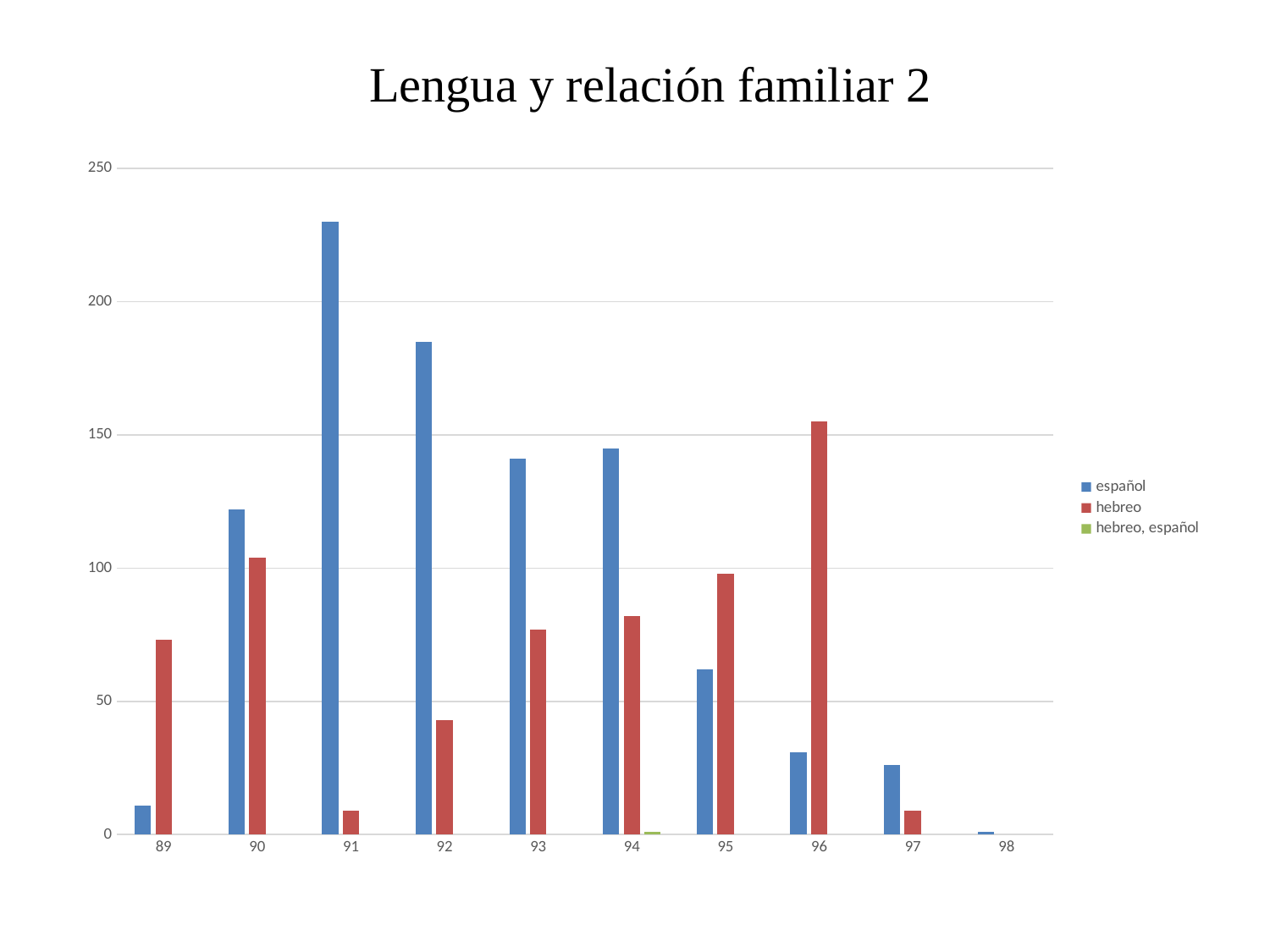
Is the español value for 91 greater or less than 200? greater For which category is the español bar the highest? 91 Is the hebreo value for 96 greater or less than 150? greater For category 92, which series has the larger value, español or hebreo? español What is the title of the chart? Lengua y relación familiar 2 How many series does the legend list? 3 Is the hebreo value for 92 greater or less than 50? less For which category is the español bar the lowest? 98 For category 89, which series has the larger value, español or hebreo? hebreo What type of chart is shown on the slide? bar chart How many categories are shown on the x axis? 10 For which category is the hebreo bar the highest? 96